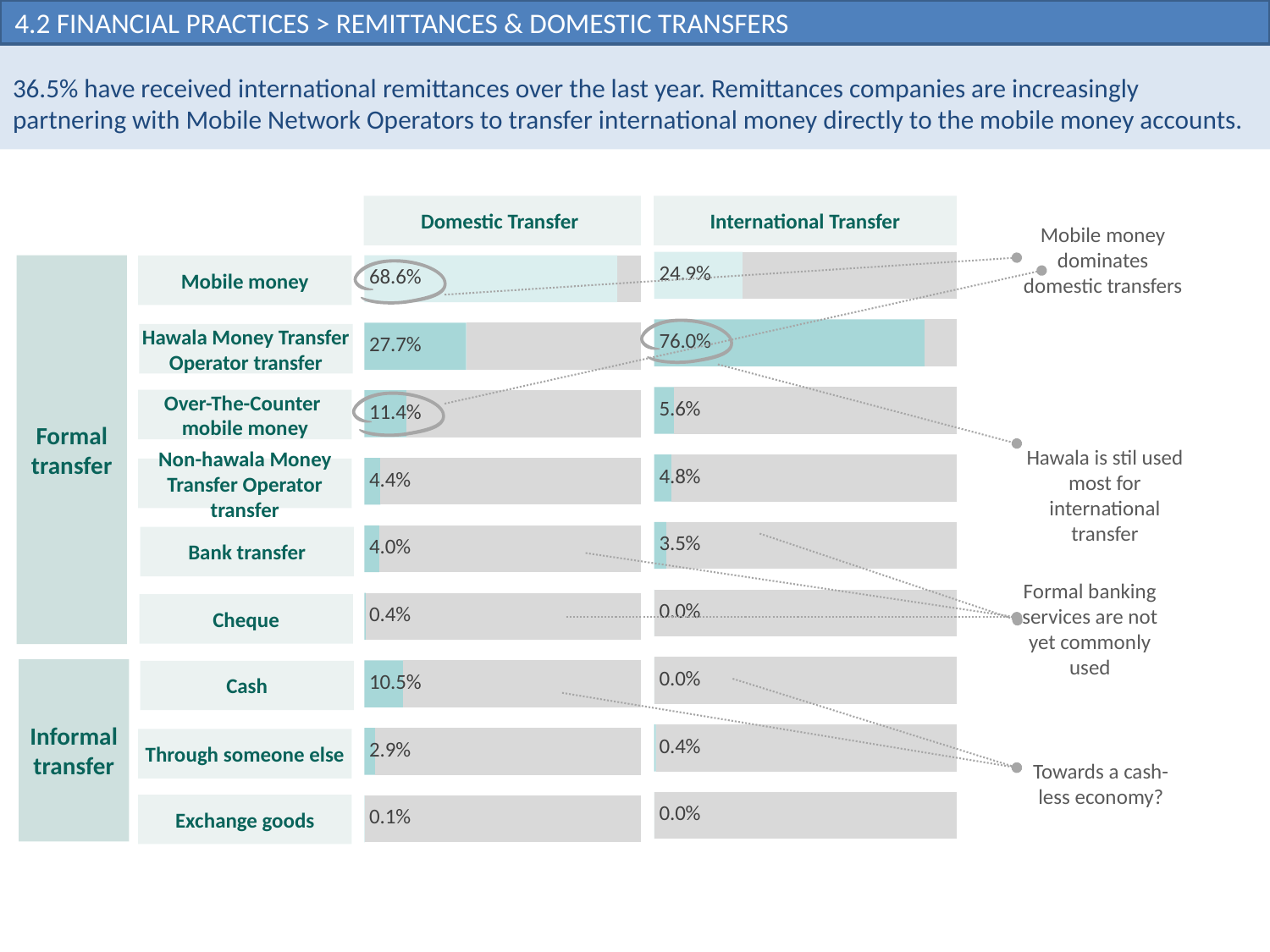
What is the International Transfer value for Hawala Money Transfer Operator transfer? 76.0% What is the Domestic Transfer value for Mobile money? 68.6% What is the difference between the Domestic Transfer and International Transfer values for Mobile money? 43.7 percentage points For Cash, which is larger: the Domestic Transfer value or the International Transfer value? Domestic Transfer What is the Domestic Transfer value for Over-The-Counter mobile money? 11.4% What are the two column headings of the chart? Domestic Transfer and International Transfer What kind of chart is used to show the transfer values? Bar chart What is the difference between the International Transfer and Domestic Transfer values for Hawala Money Transfer Operator transfer? 48.3 percentage points Which category has the highest International Transfer value? Hawala Money Transfer Operator transfer How many transfer method categories are shown in the chart? 9 Which category has the lowest Domestic Transfer value? Exchange goods Which category has the highest Domestic Transfer value? Mobile money